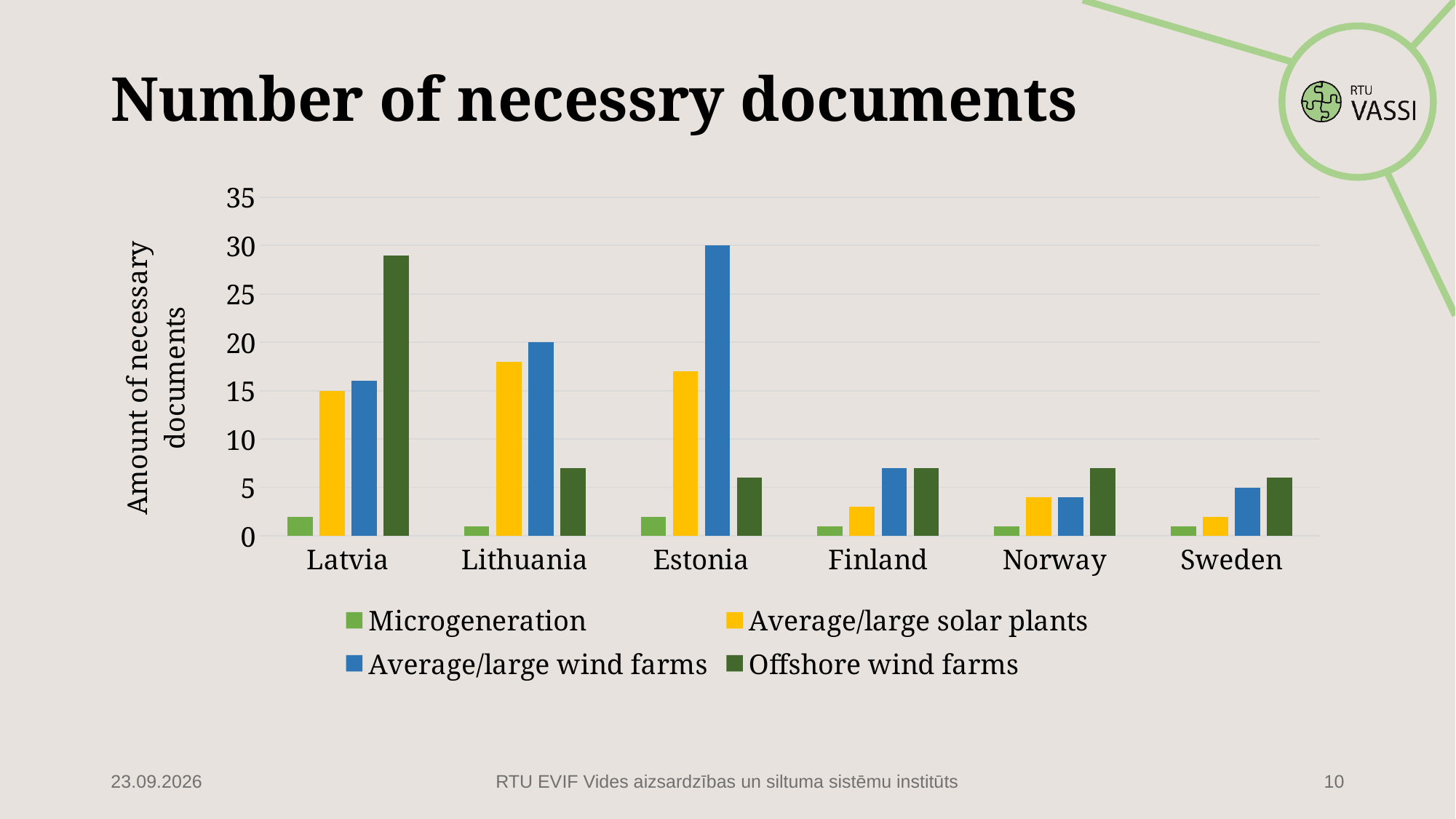
Is the value for Offshore wind farms in Estonia greater or less than 10? less Is the value for Offshore wind farms in Latvia greater or less than 25? greater What is the label of the vertical axis? Amount of necessary documents What is the title of the chart on the slide? Number of necessry documents What is the value for Average/large wind farms in Lithuania? 20 In Latvia, which is larger: Offshore wind farms or Average/large wind farms? Offshore wind farms How many series does the chart legend list? 4 What is the value for Average/large wind farms in Estonia? 30 What is the value for Average/large solar plants in Latvia? 15 What type of chart is shown on the slide? bar chart Which country has the highest value for Offshore wind farms? Latvia How many countries are shown on the x axis of the chart? 6